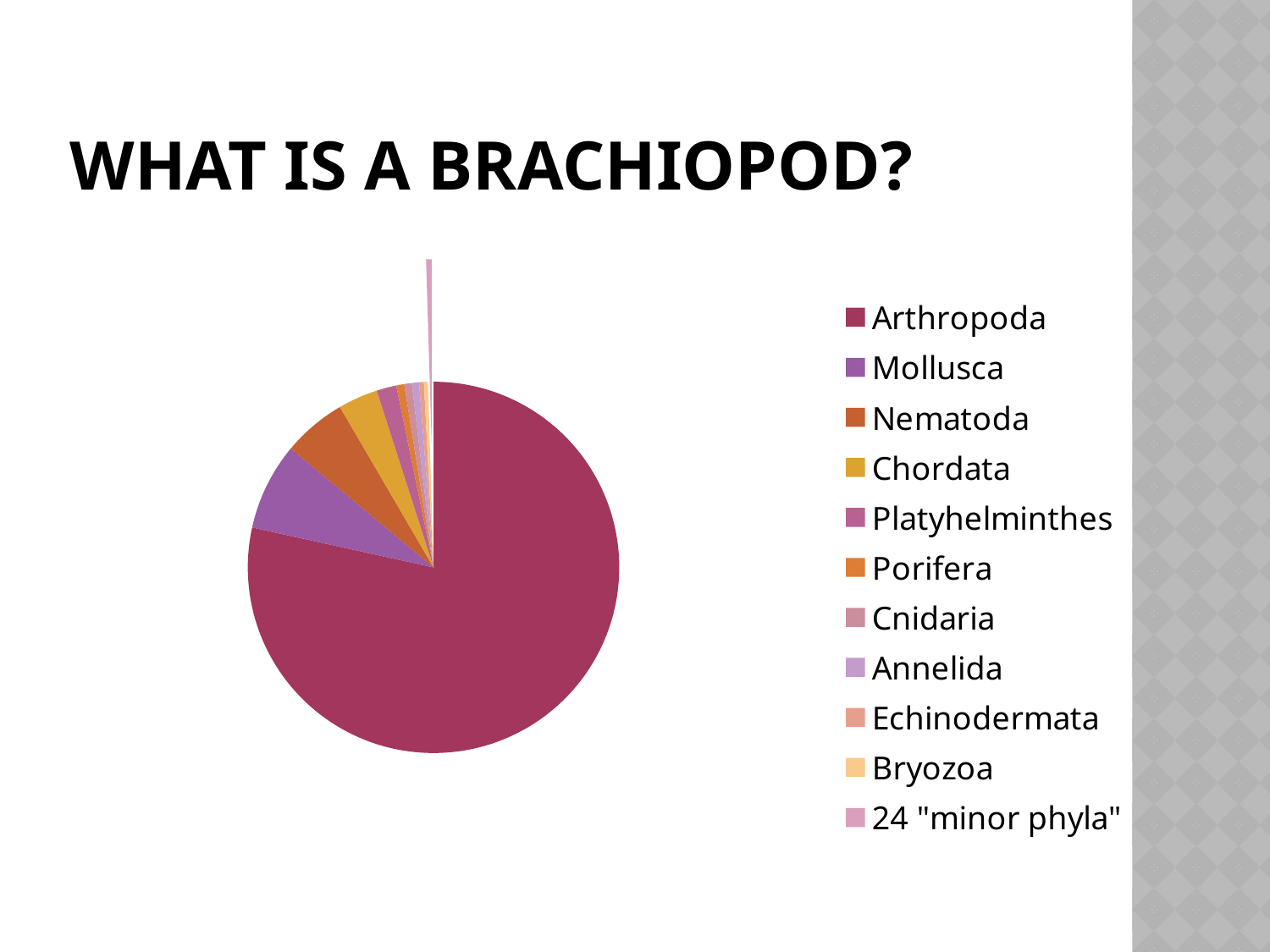
Which slice is larger, Mollusca or Chordata? Mollusca What is the title of the slide containing the pie chart? WHAT IS A BRACHIOPOD? Which category has the largest slice of the pie chart? Arthropoda Which category is listed first in the pie chart's legend? Arthropoda Which slice is larger, Chordata or Arthropoda? Arthropoda What kind of chart is shown on the slide? Pie chart How many categories (slices) does the pie chart's legend list? 11 What is the last entry listed in the pie chart's legend? 24 "minor phyla" Does the Arthropoda slice take up more or less than half of the pie? more Which slice is larger, Mollusca or Nematoda? Mollusca